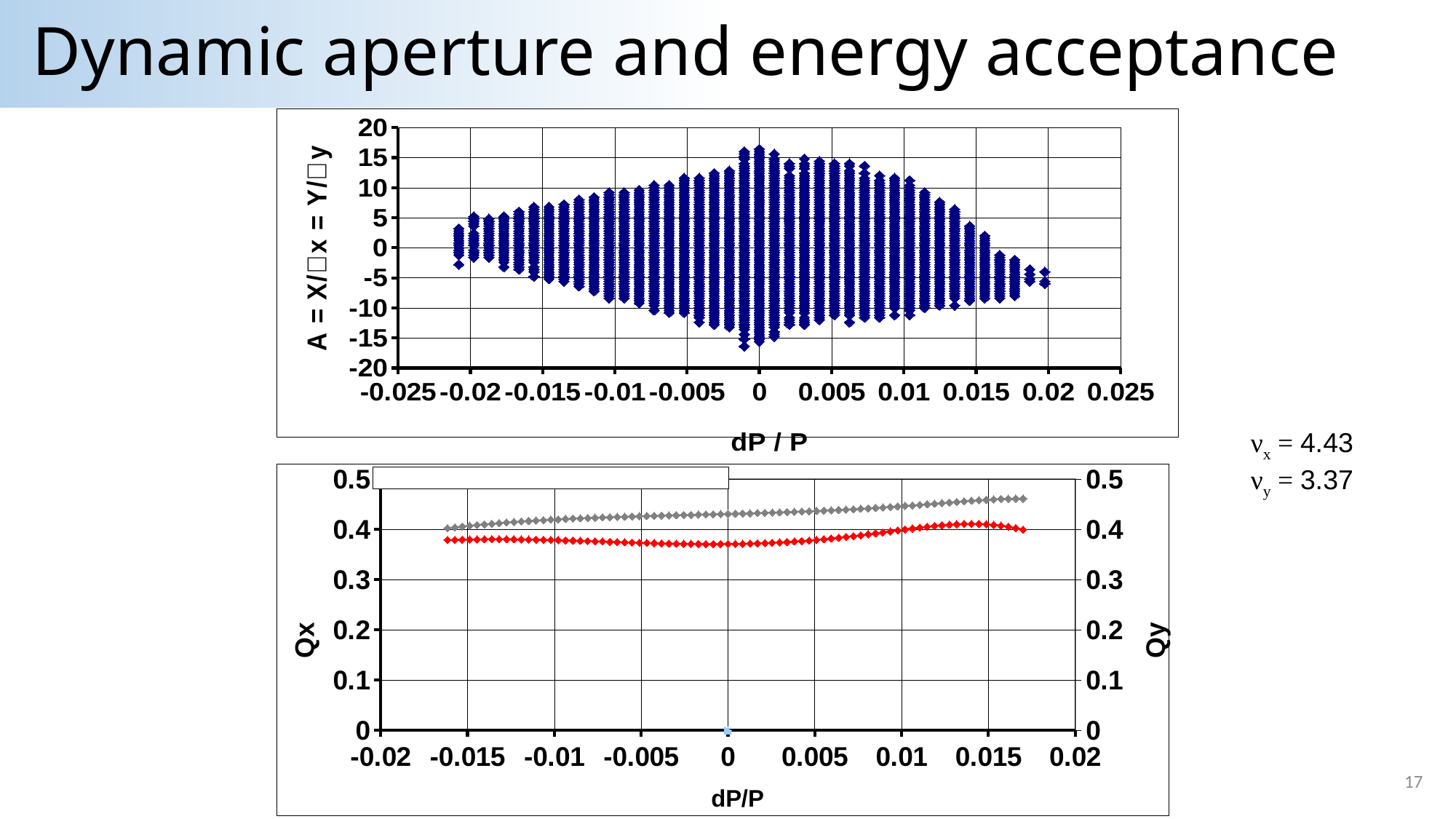
In the bottom chart, is the grey series value at dP/P = 0 greater or less than 0.4? greater In the bottom chart, is the red series value at dP/P = 0.015 greater or less than 0.3? greater In the top chart, is the maximum A value at dP / P = 0 greater or less than 15? greater What is the highest tick value shown on the y-axis of the top chart? 20 In the bottom chart, does the grey series rise or fall as dP/P increases from -0.015 to 0.015? rise In the bottom chart, which series is higher at dP/P = 0, the grey series or the red series? grey series What kind of chart is the top chart (A = X/σx = Y/σy versus dP / P)? scatter chart What is the x-axis title of the top chart? dP / P